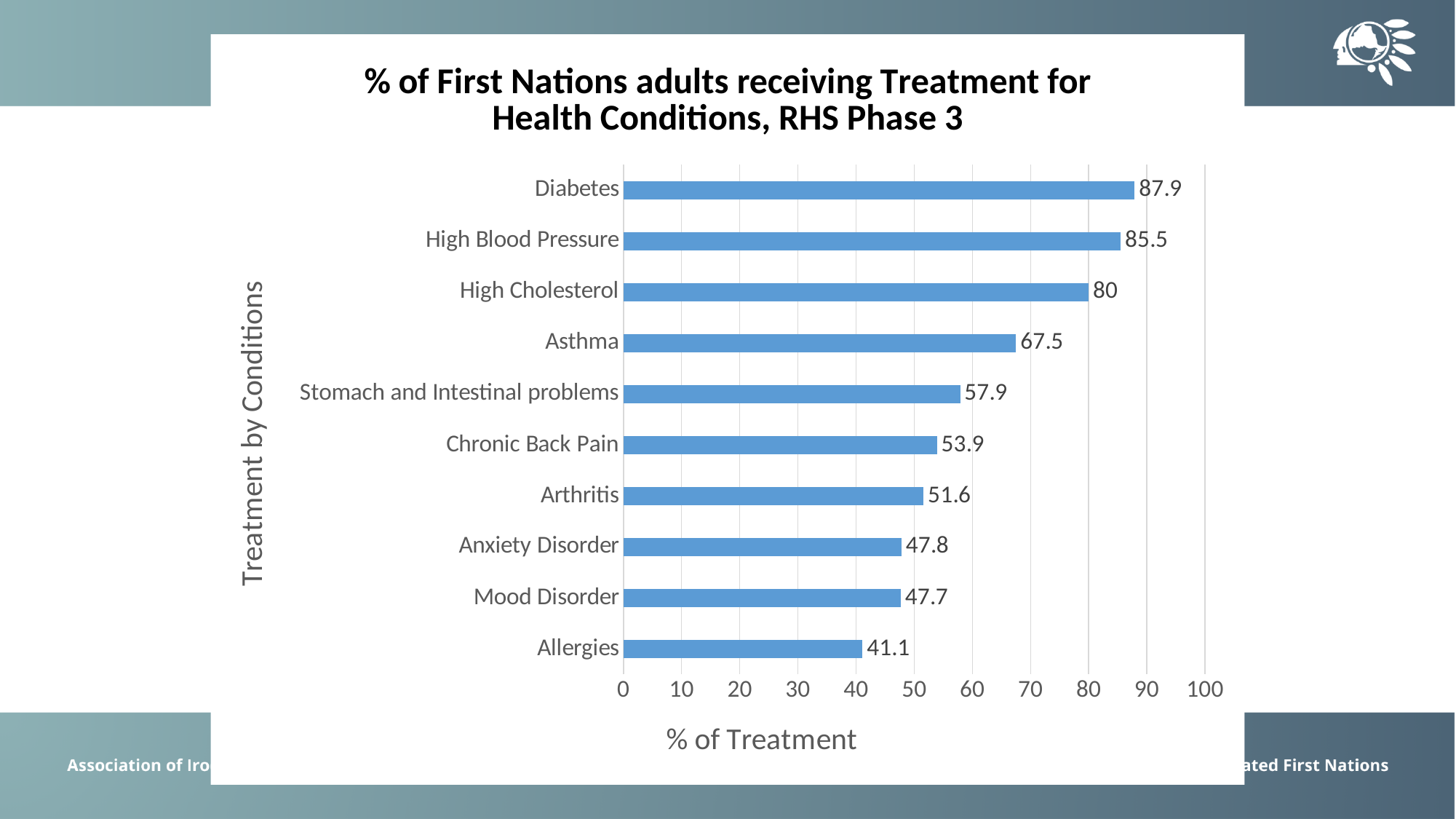
What is the difference between the values for High Cholesterol and Asthma? 12.5 Which condition has the lowest percentage receiving treatment? Allergies What is the label of the horizontal axis? % of Treatment Which condition has the highest percentage receiving treatment? Diabetes Which is larger, the value for Chronic Back Pain or the value for Arthritis? Chronic Back Pain What is the value for Diabetes? 87.9 Is the value for Asthma greater or less than 60? greater What kind of chart is shown on the slide? Bar chart What is the value for Allergies? 41.1 What is the value for Stomach and Intestinal problems? 57.9 What is the difference between the values for Diabetes and High Blood Pressure? 2.4 How many conditions are shown in the chart? 10